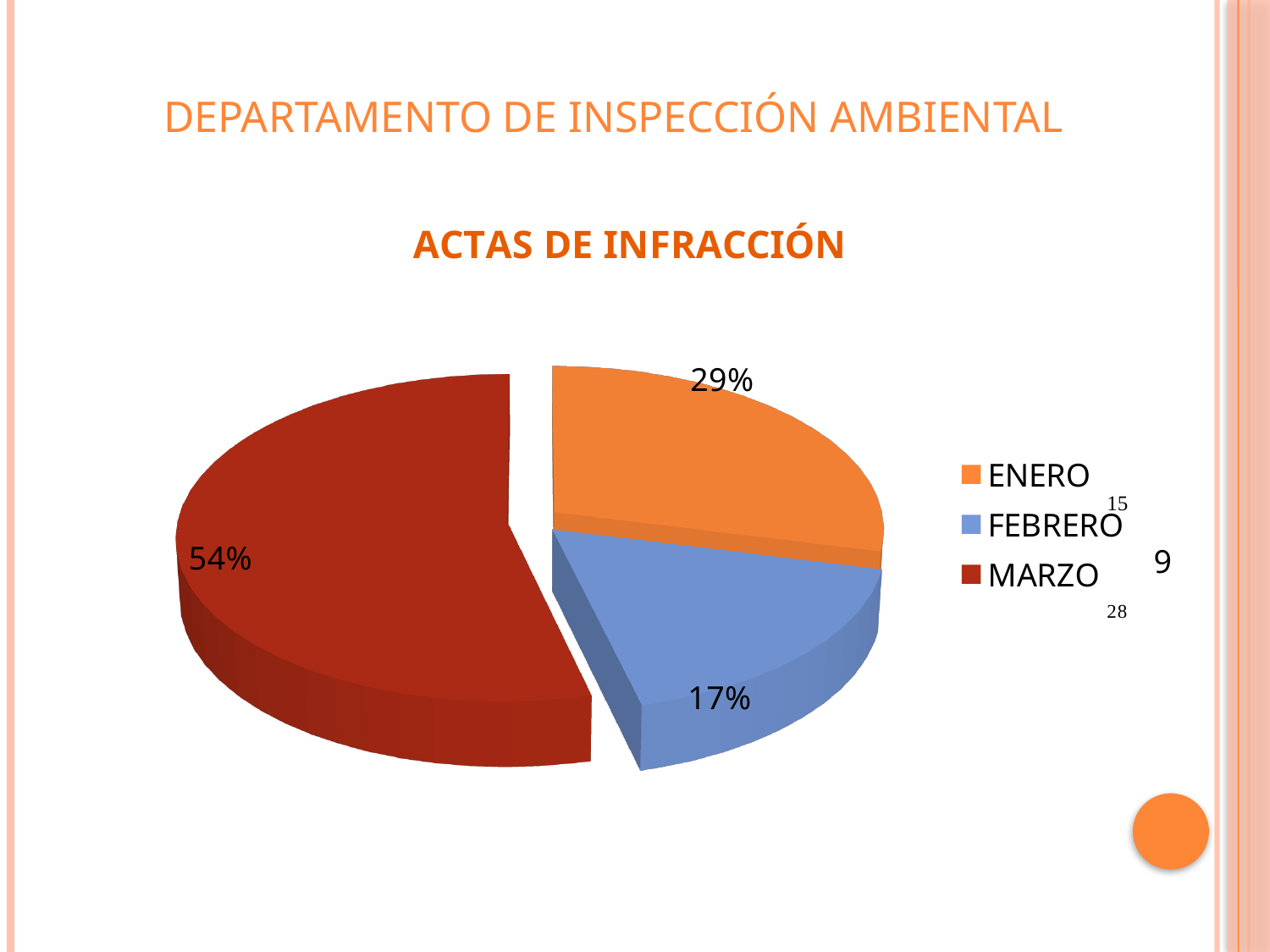
How many slices does the pie chart have? 3 What is the difference in percentage points between the MARZO slice and the ENERO slice? 25% What percentage of the pie chart does MARZO represent? 54% What percentage of the pie chart does FEBRERO represent? 17% Which colour represents MARZO in the pie chart? Red What type of chart is shown on the slide? Pie chart What is the difference in percentage points between the ENERO slice and the FEBRERO slice? 12% Which month has the largest slice of the pie chart? MARZO Which slice is larger, ENERO or FEBRERO? ENERO Which month has the smallest slice of the pie chart? FEBRERO What is the title of the chart? ACTAS DE INFRACCIÓN What percentage of the pie chart does ENERO represent? 29%